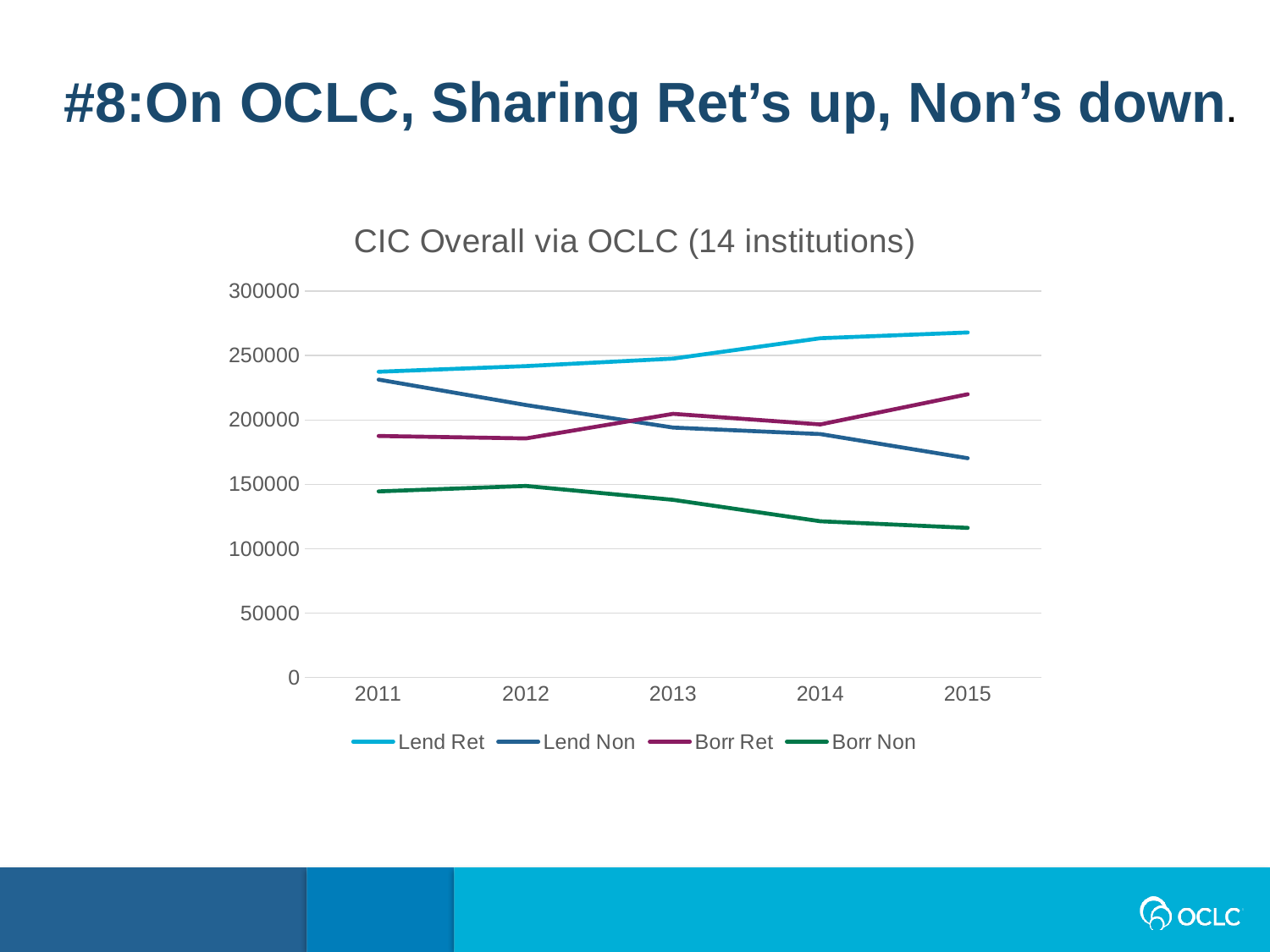
How many years are plotted along the x axis? 5 Which series has the lowest value in 2011? Borr Non What kind of chart is shown on the slide? line chart In 2011, which is larger: Lend Non or Borr Ret? Lend Non Is the value for Lend Non in 2015 greater or less than 200000? less Is the value for Borr Non in 2015 greater or less than 150000? less What is the title of the chart? CIC Overall via OCLC (14 institutions) Does the Lend Non series rise or fall from 2011 to 2015? fall Is the value for Lend Ret in 2015 greater or less than 250000? greater Which series has the highest value in 2015? Lend Ret How many series does the legend list? 4 Does the Lend Ret series rise or fall from 2011 to 2015? rise